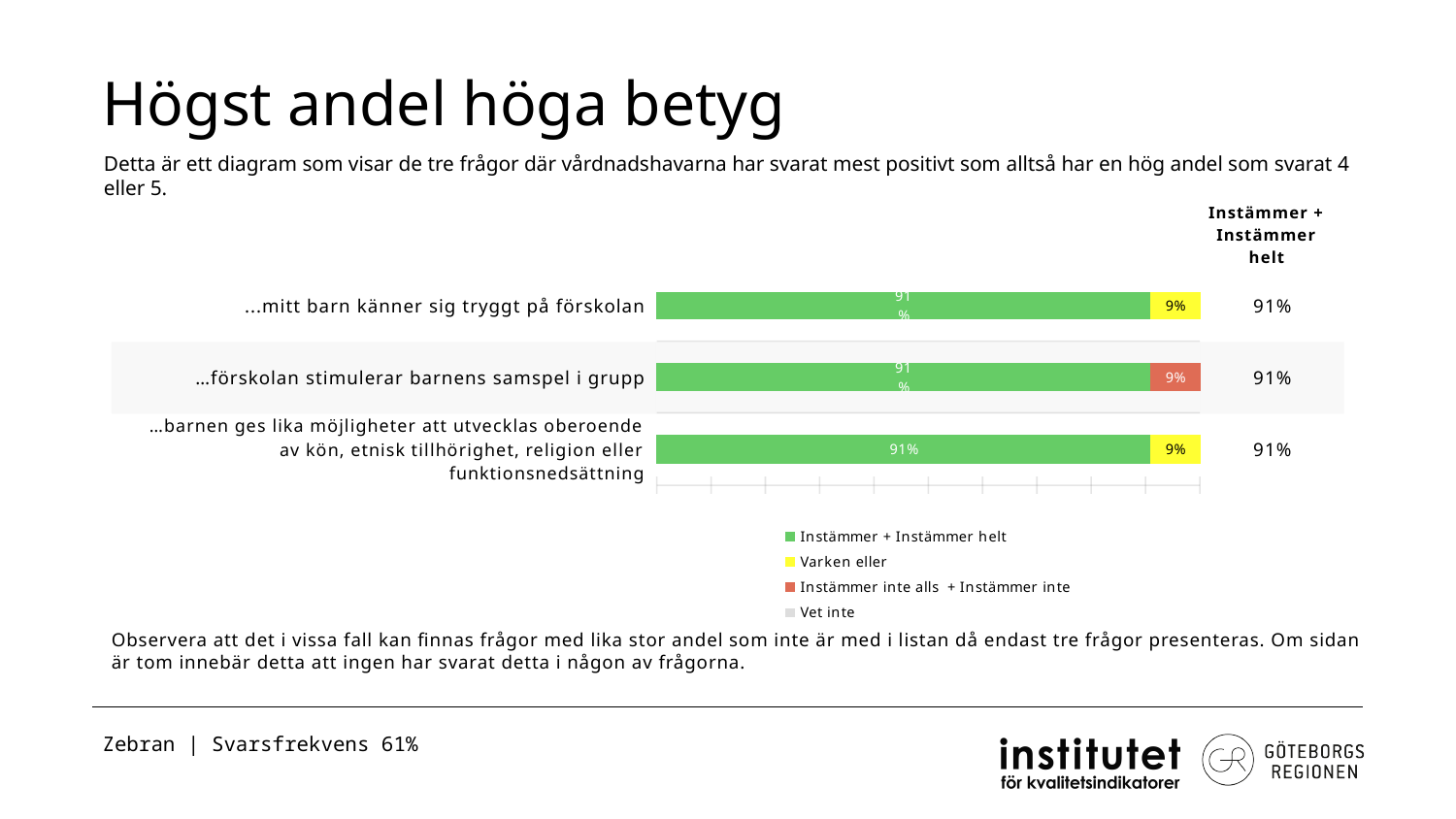
How many series does the chart legend list? 4 What is the difference between the 'Instämmer + Instämmer helt' value and the 'Varken eller' value for '…mitt barn känner sig tryggt på förskolan'? 82% What is the 'Varken eller' value for '…mitt barn känner sig tryggt på förskolan'? 9% What is the title of the slide containing the chart? Högst andel höga betyg What is the 'Instämmer + Instämmer helt' value for '…barnen ges lika möjligheter att utvecklas oberoende av kön, etnisk tillhörighet, religion eller funktionsnedsättning'? 91% Which colour represents 'Instämmer + Instämmer helt' in the chart? green What is the 'Instämmer + Instämmer helt' value for '…förskolan stimulerar barnens samspel i grupp'? 91% How many categories (questions) are plotted in the chart? 3 What is the total of the stacked bar for '…förskolan stimulerar barnens samspel i grupp'? 100% What is the 'Instämmer + Instämmer helt' value for '…mitt barn känner sig tryggt på förskolan'? 91% What is the 'Instämmer inte alls + Instämmer inte' value for '…förskolan stimulerar barnens samspel i grupp'? 9% What kind of chart is shown on the slide? stacked bar chart